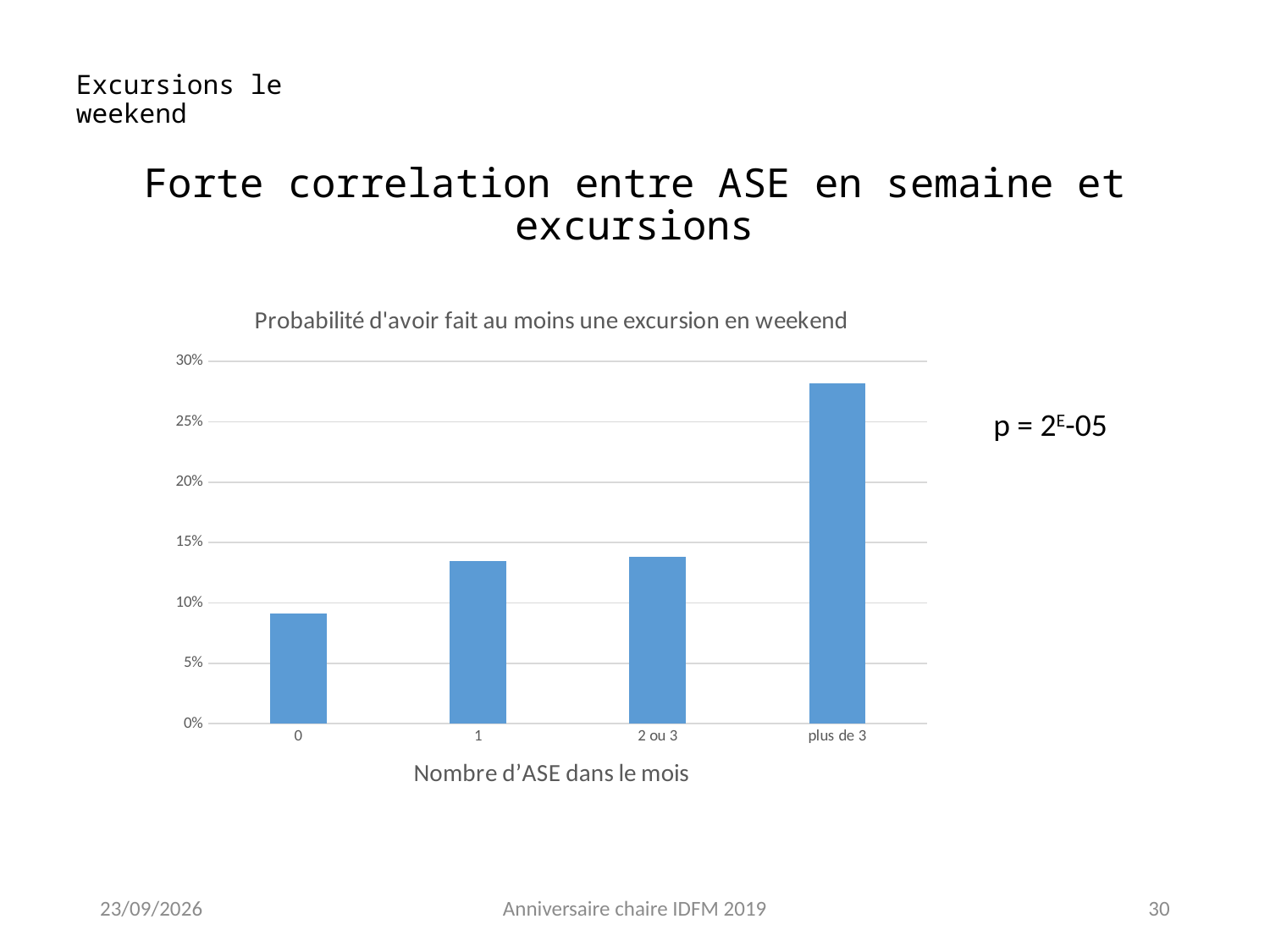
Which category has the lowest probability in the chart? 0 Which has the larger value, the category "0" or the category "1"? 1 What kind of chart is shown on the slide? bar chart Is the value for the category "2 ou 3" greater or less than 15%? less Is the value for the category "1" greater or less than 10%? greater What is the label of the x axis of the chart? Nombre d’ASE dans le mois Is the value for the category "0" greater or less than 10%? less What is the title of the chart? Probabilité d'avoir fait au moins une excursion en weekend Which category has the highest probability in the chart? plus de 3 How many categories are shown on the x axis of the chart? 4 Do the values rise or fall as you move from "0" to "plus de 3" along the x axis? rise